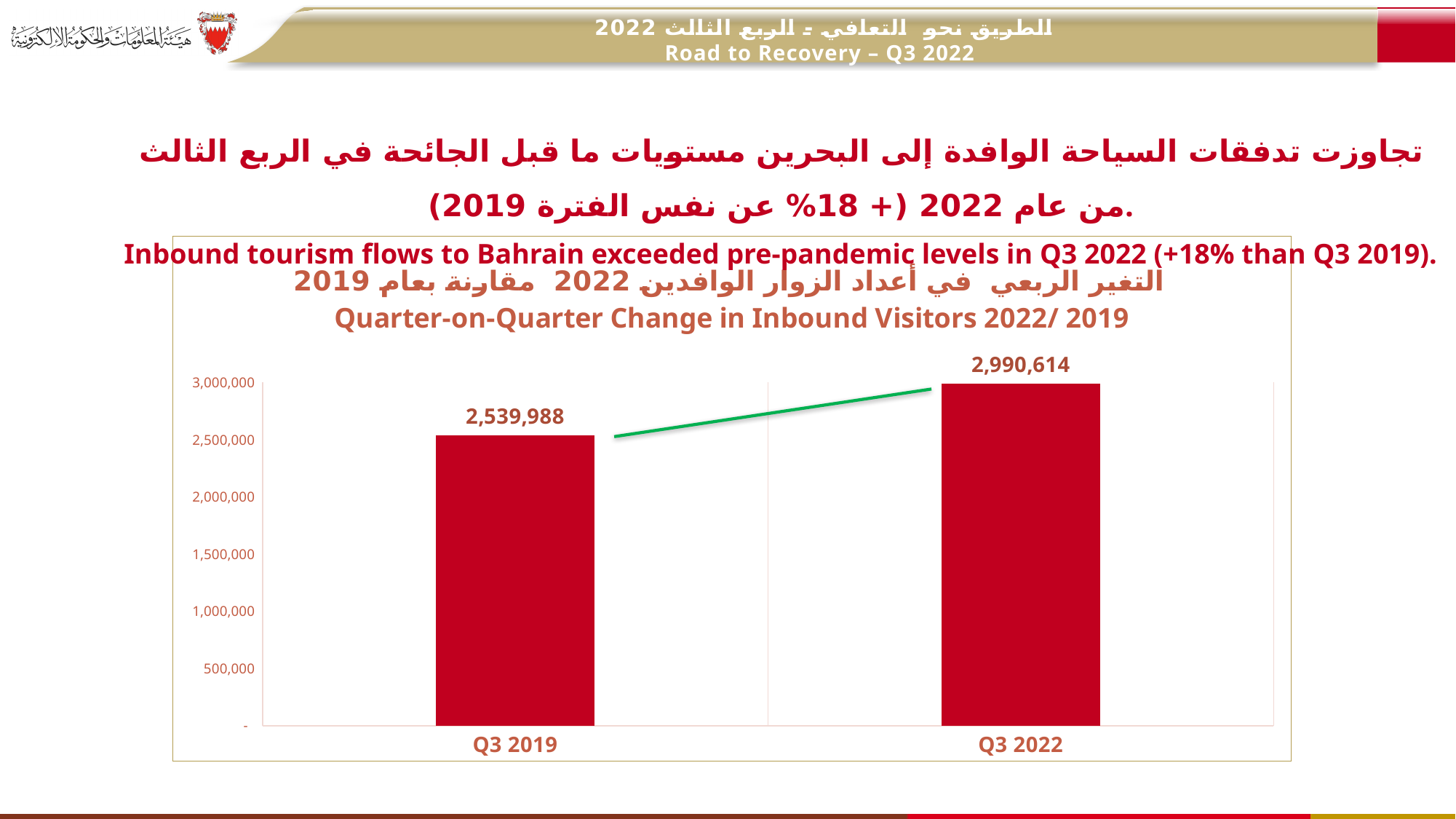
What is the English title of the chart? Quarter-on-Quarter Change in Inbound Visitors 2022/ 2019 Which is larger, the value for Q3 2019 or the value for Q3 2022? Q3 2022 What is the value for Q3 2022? 2,990,614 Which category has the highest value? Q3 2022 Is the value for Q3 2022 greater or less than 3,000,000? less What is the difference between the values for Q3 2022 and Q3 2019? 450,626 Which category has the lowest value? Q3 2019 What kind of chart is shown on the slide? Bar chart Do the values rise or fall from Q3 2019 to Q3 2022? Rise Is the value for Q3 2019 greater or less than 2,500,000? greater How many categories are shown on the x axis? 2 What is the value for Q3 2019? 2,539,988